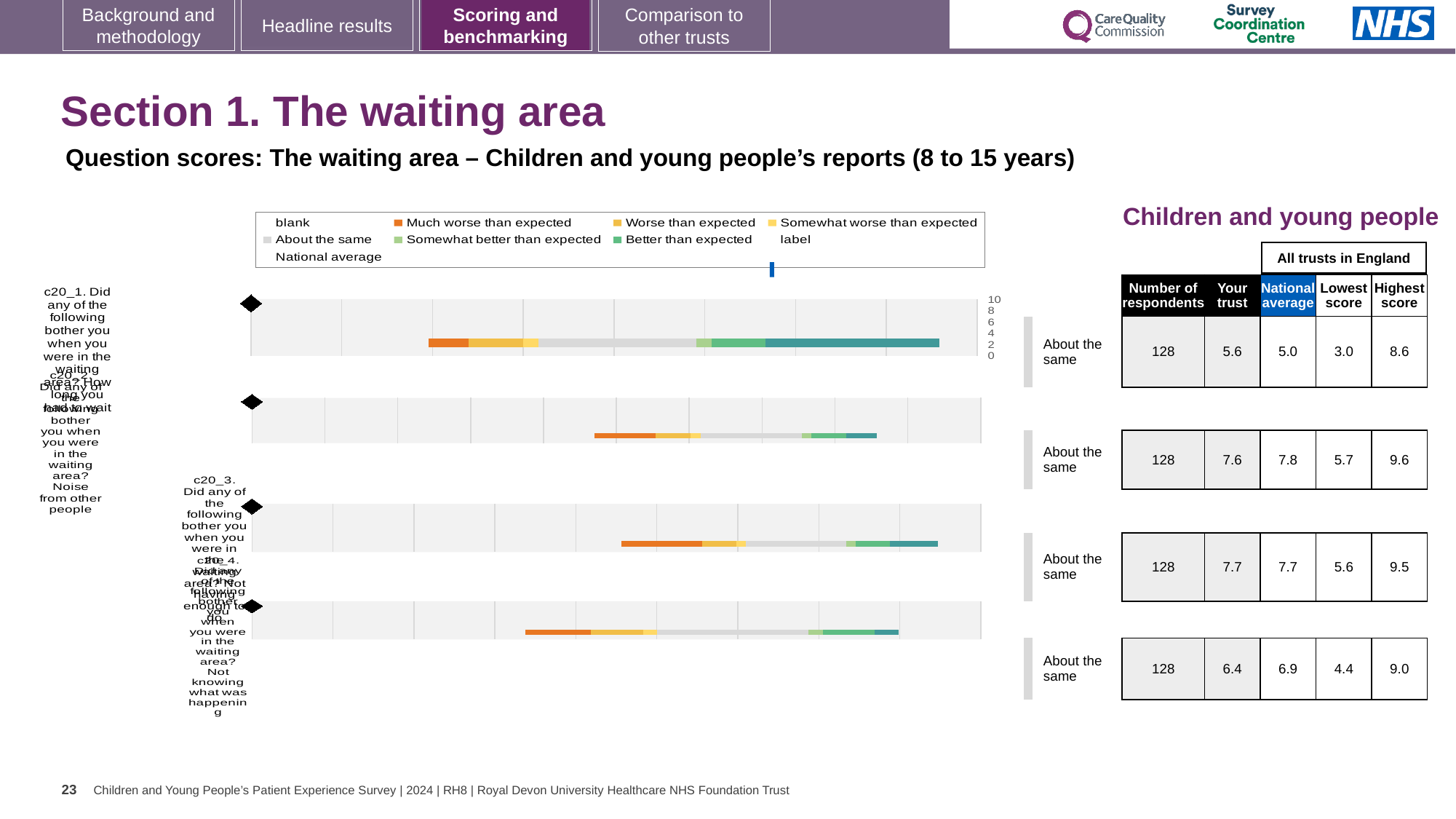
In the legend, what colour represents 'Better than expected'? teal In the legend, what colour represents 'Much worse than expected'? orange How many separate bar charts (one per question) are shown on the slide? 4 Which of the four charts has the highest 'Your trust' score in the table? the third chart (c20_3), 7.7 How many entries does the legend above the charts list? 9 What benchmark label is shown next to each of the four charts? About the same In the table beside the second chart (c20_2), what is the national average score? 7.8 For the first chart (c20_1), what is the difference between the highest score and the lowest score in the table? 5.6 What kind of chart is used to show the question scores on this slide? bar chart Which of the four charts has the lowest 'Your trust' score in the table? the first chart (c20_1), 5.6 In the table beside the first chart (c20_1), what is the 'Your trust' score? 5.6 For the second chart (c20_2), which is larger: the 'Your trust' score or the national average? national average